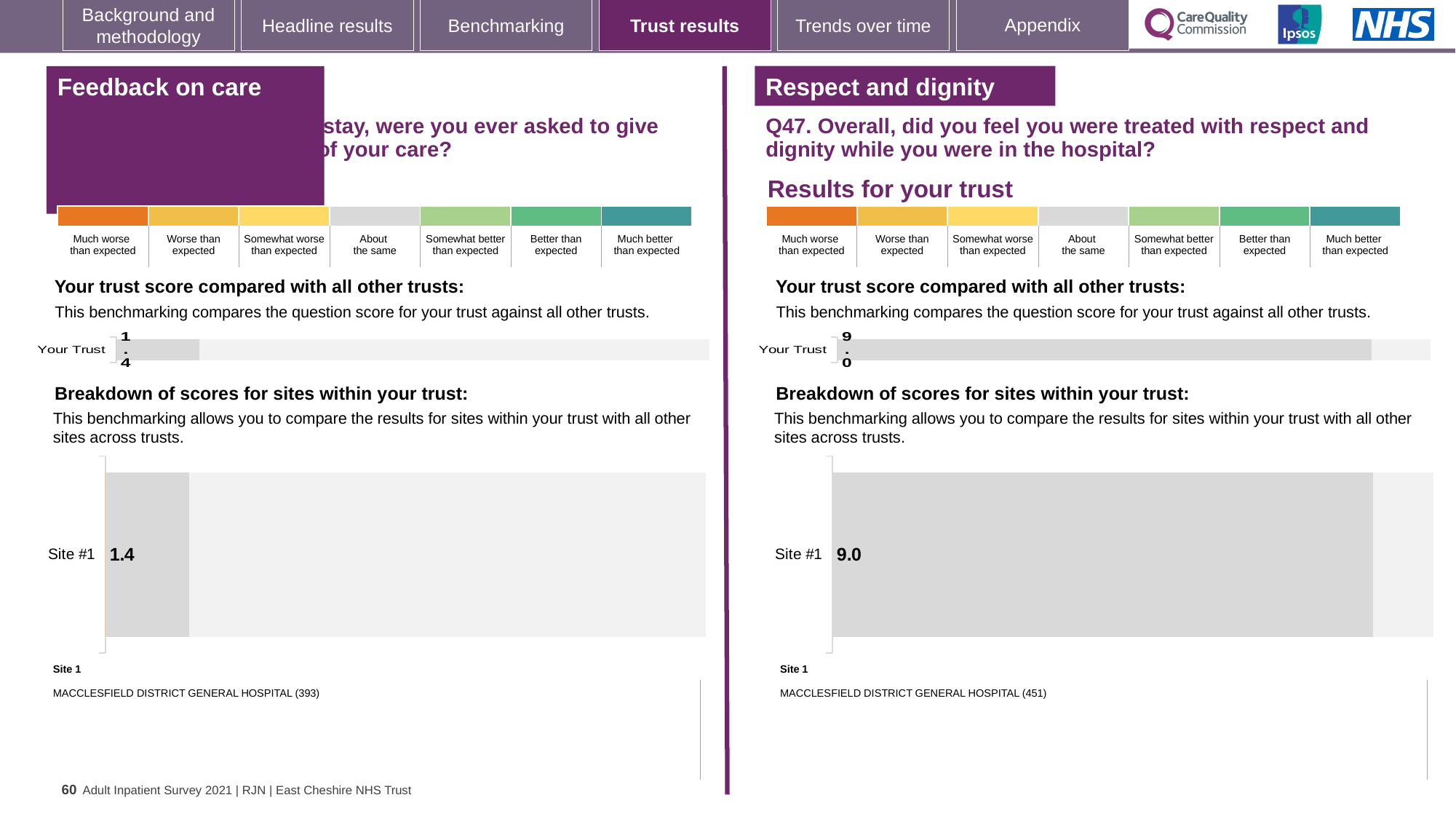
How many sites are shown in the 'Breakdown of scores for sites within your trust' chart on the left (Feedback on care)? 1 Which hospital is listed as Site 1 under the Respect and dignity breakdown chart? MACCLESFIELD DISTRICT GENERAL HOSPITAL (451) What is the difference between the Site #1 score in the Respect and dignity breakdown chart and the Site #1 score in the Feedback on care breakdown chart? 7.6 Which hospital is listed as Site 1 under the Feedback on care breakdown chart? MACCLESFIELD DISTRICT GENERAL HOSPITAL (393) In the 'Breakdown of scores for sites within your trust' chart on the left (Feedback on care), what is the value for Site #1? 1.4 Which is larger: the Site #1 score in the Feedback on care breakdown chart or the Site #1 score in the Respect and dignity breakdown chart? Respect and dignity On the 'Feedback on care' section, what is the score shown for Your Trust in the 'Your trust score compared with all other trusts' chart? 1.4 In the 'Breakdown of scores for sites within your trust' chart on the right (Respect and dignity), what is the value for Site #1? 9.0 What type of chart is used to show the Site #1 score in the Respect and dignity breakdown section? Bar chart How many sites are shown in the 'Breakdown of scores for sites within your trust' chart on the right (Respect and dignity)? 1 On the 'Respect and dignity' section, what is the score shown for Your Trust in the 'Your trust score compared with all other trusts' chart? 9.0